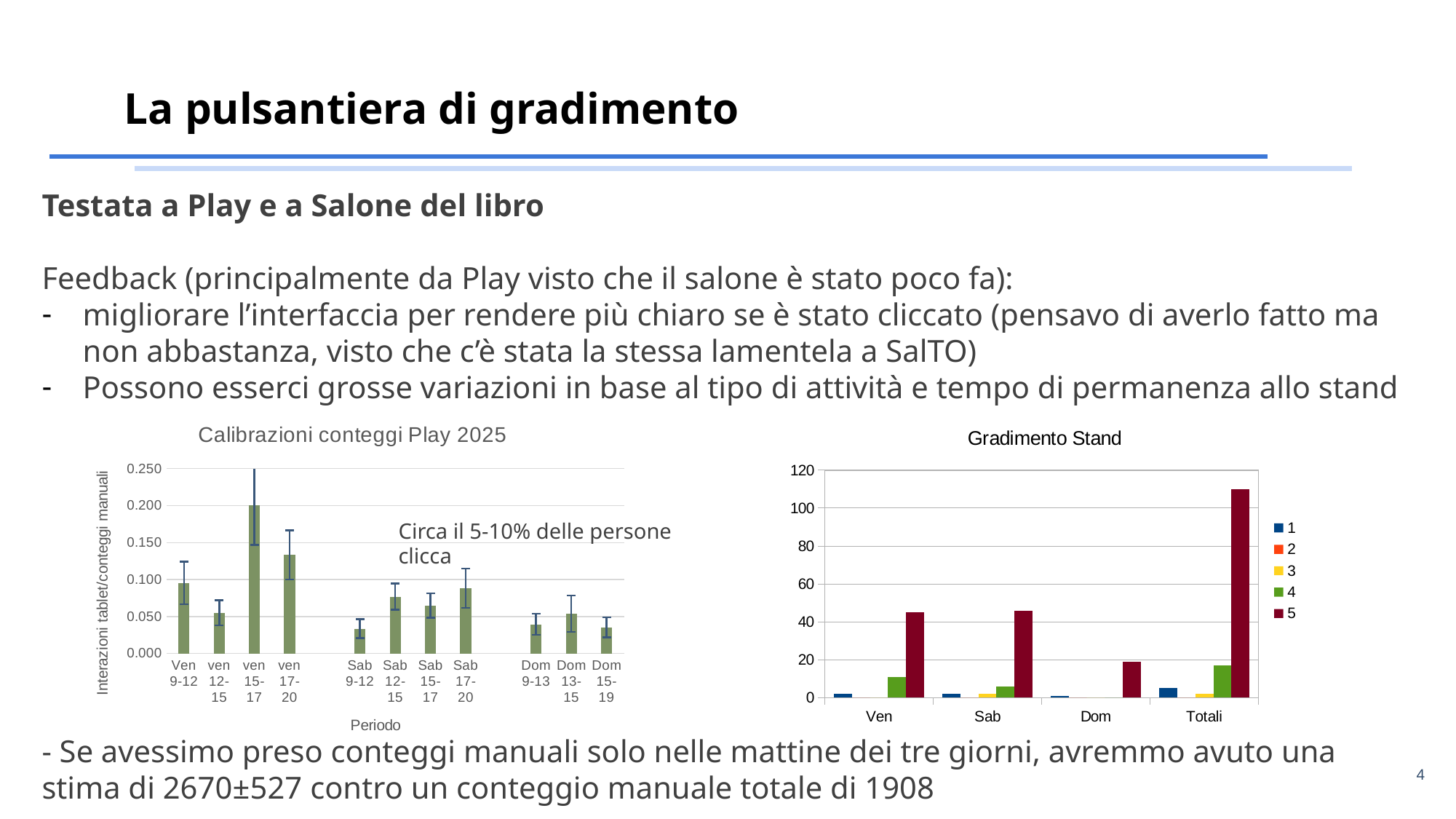
In the 'Calibrazioni conteggi Play 2025' chart, is the value for Sab 12-15 greater or less than 0.100? less What type of chart is the 'Calibrazioni conteggi Play 2025' chart? bar chart What is the y-axis title of the 'Calibrazioni conteggi Play 2025' chart? Interazioni tablet/conteggi manuali In the 'Calibrazioni conteggi Play 2025' chart, which period has the highest value? ven 15-17 In the 'Calibrazioni conteggi Play 2025' chart, how many time-period categories are shown on the x axis? 11 In the 'Calibrazioni conteggi Play 2025' chart, which is larger: the value for ven 15-17 or ven 17-20? ven 15-17 In the 'Gradimento Stand' chart, is the value of series 4 for Totali greater or less than 20? less In the 'Calibrazioni conteggi Play 2025' chart, is the value for ven 15-17 greater or less than 0.150? greater How many categories are shown on the x axis of the 'Gradimento Stand' chart? 4 In the 'Gradimento Stand' chart, which series has the tallest bar in the Totali category? 5 How many series does the legend of the 'Gradimento Stand' chart list? 5